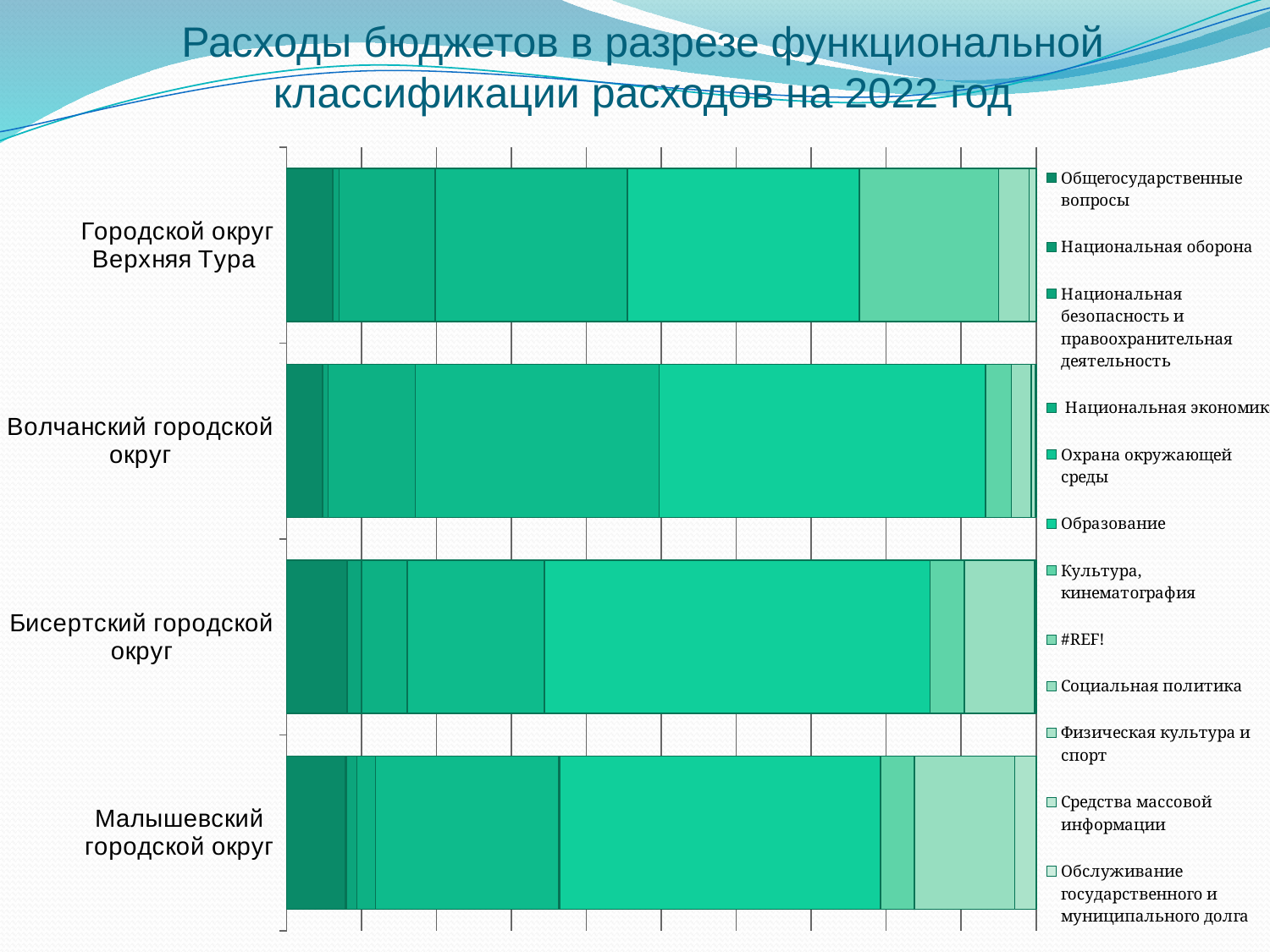
What is the title of the chart on the slide? Расходы бюджетов в разрезе функциональной классификации расходов на 2022 год Which category is listed at the bottom of the chart? Малышевский городской округ Is the share of Образование larger for Бисертский городской округ or for Городской округ Верхняя Тура? Бисертский городской округ Which expenditure series takes the largest share of the bar for Волчанский городской округ? Образование Which expenditure series takes the largest share of the bar for Бисертский городской округ? Образование Which legend entry on the chart shows an error value instead of a name? #REF! What type of chart is shown on the slide? Stacked bar chart Which category is listed at the top of the chart? Городской округ Верхняя Тура How many series does the chart legend list? 12 Which category has the smallest share of Образование in its bar? Городской округ Верхняя Тура Which category has the largest share of Образование in its bar? Бисертский городской округ How many municipal districts (categories) are plotted on the chart? 4